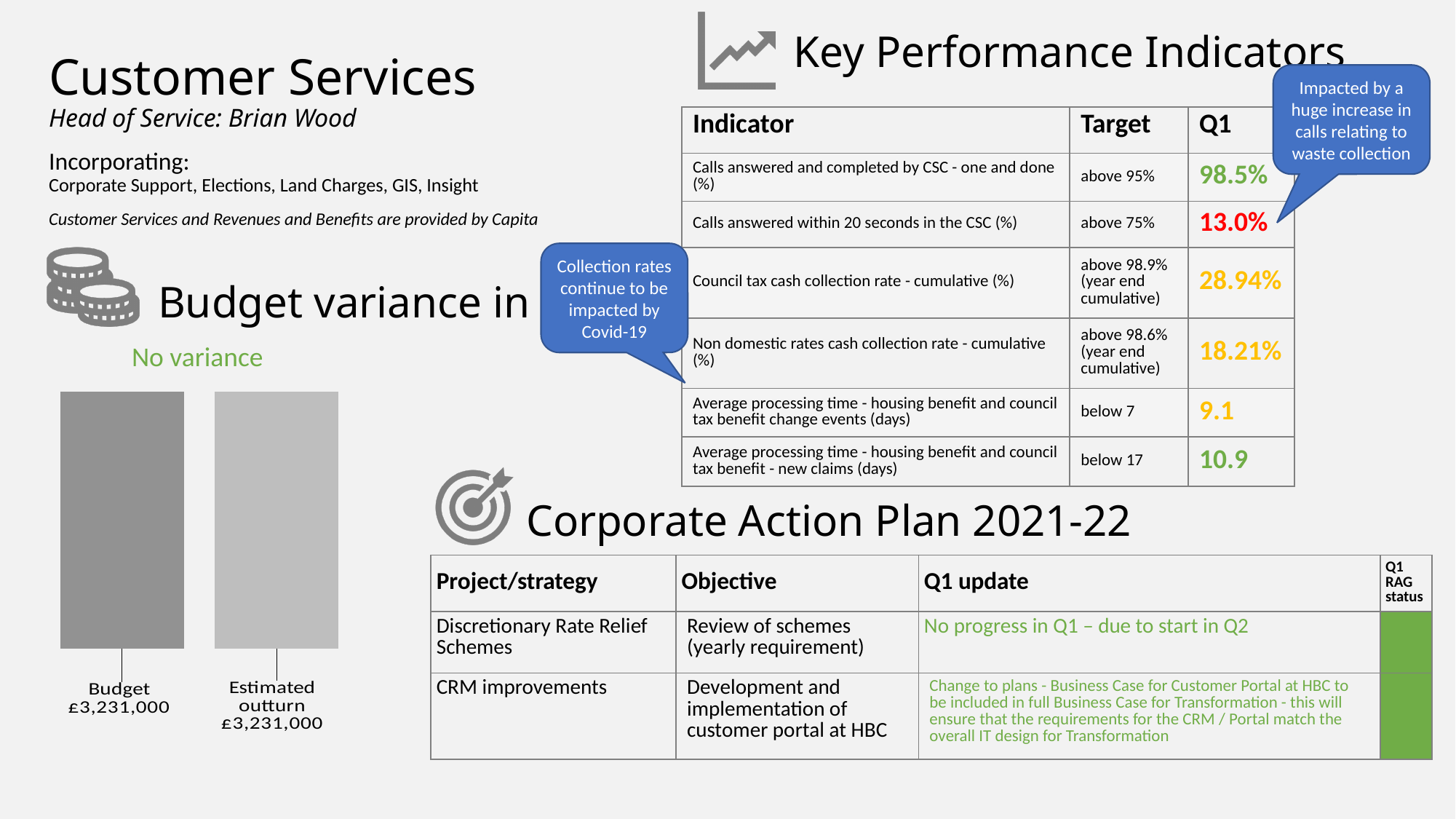
What is the value of the Budget bar in the budget variance chart? £3,231,000 How many bars are shown in the budget variance chart? 2 What text in green appears above the budget variance chart describing the variance? No variance What are the two category labels on the budget variance chart? Budget and Estimated outturn What is the value of the Estimated outturn bar in the budget variance chart? £3,231,000 Is the Budget value in the budget variance chart greater or less than £3,000,000? greater Is the Estimated outturn value in the budget variance chart greater or less than £4,000,000? less What is the difference between the Budget and Estimated outturn values in the budget variance chart? £0 What kind of chart is used to show the budget variance? Bar chart